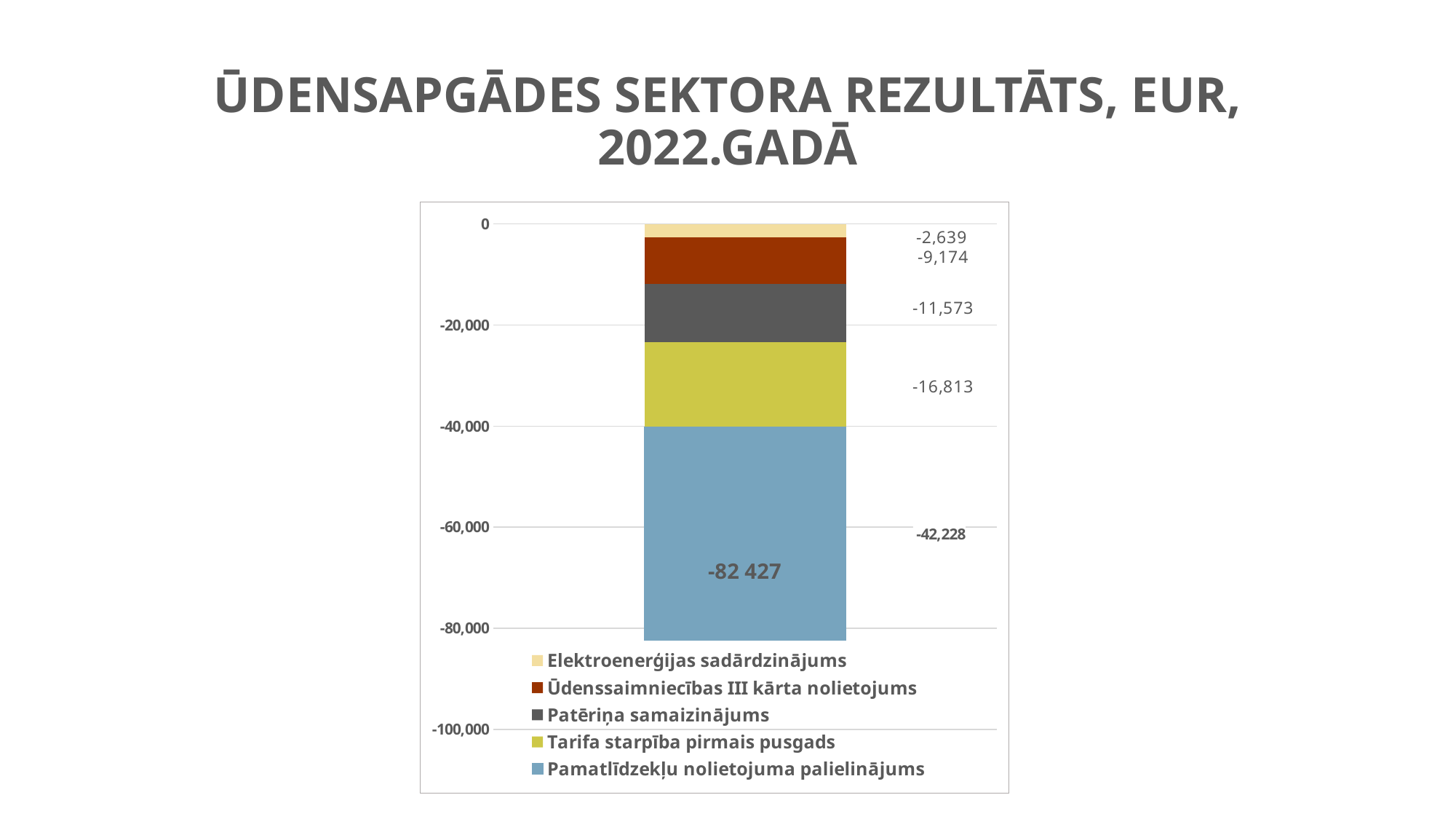
Which series has the largest magnitude in the stacked bar? Pamatlīdzekļu nolietojuma palielinājums What is the value for Patēriņa samaizinājums? -11,573 What is the title of the chart? ŪDENSAPGĀDES SEKTORA REZULTĀTS, EUR, 2022.GADĀ What is the value for Ūdenssaimniecības III kārta nolietojums? -9,174 What kind of chart is shown on the slide? stacked bar chart How many series does the legend list? 5 What is the difference between the values for Tarifa starpība pirmais pusgads and Patēriņa samaizinājums? 5,240 What is the value for Elektroenerģijas sadārdzinājums? -2,639 What is the value for Tarifa starpība pirmais pusgads? -16,813 What is the total of the stacked bar? -82 427 What is the value for Pamatlīdzekļu nolietojuma palielinājums? -42,228 Which series has the smallest magnitude in the stacked bar? Elektroenerģijas sadārdzinājums